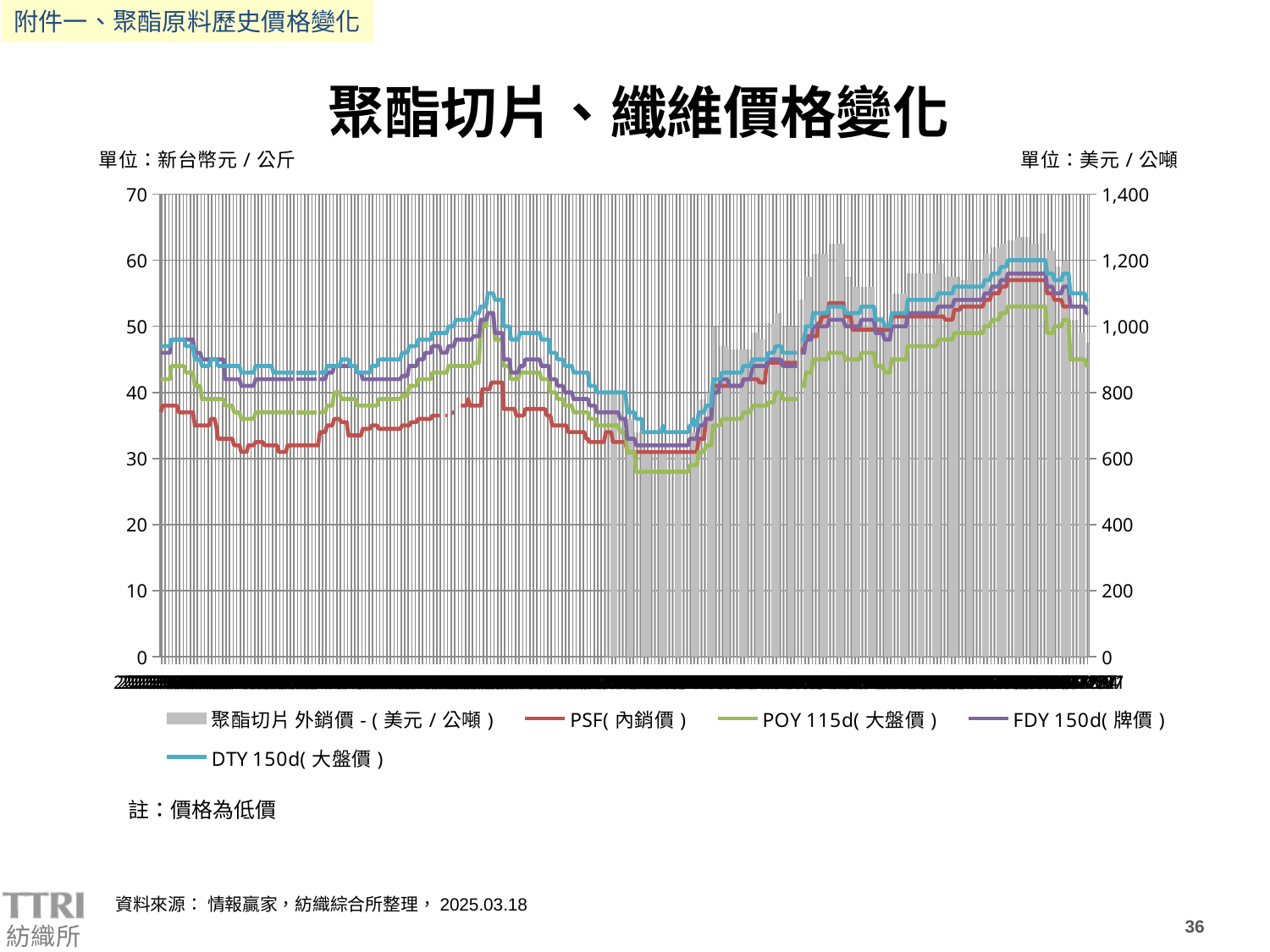
Is the lowest value of the POY 115d(大盤價) line greater or less than 20 on the left axis? greater At the right end of the chart, which line is higher, DTY 150d(大盤價) or POY 115d(大盤價)? DTY 150d(大盤價) Is the highest value of the PSF(內銷價) line greater or less than 60 on the left axis? less Is the tallest 聚酯切片 外銷價 bar greater or less than 1,400 on the right axis? less How many series does the chart legend list? 5 What is the title of the chart? 聚酯切片、纖維價格變化 Does the PSF(內銷價) line end higher or lower than it starts? higher What kind of chart is this? Combination bar and line chart Which series is drawn as grey bars rather than a line? 聚酯切片 外銷價 - (美元/公噸)